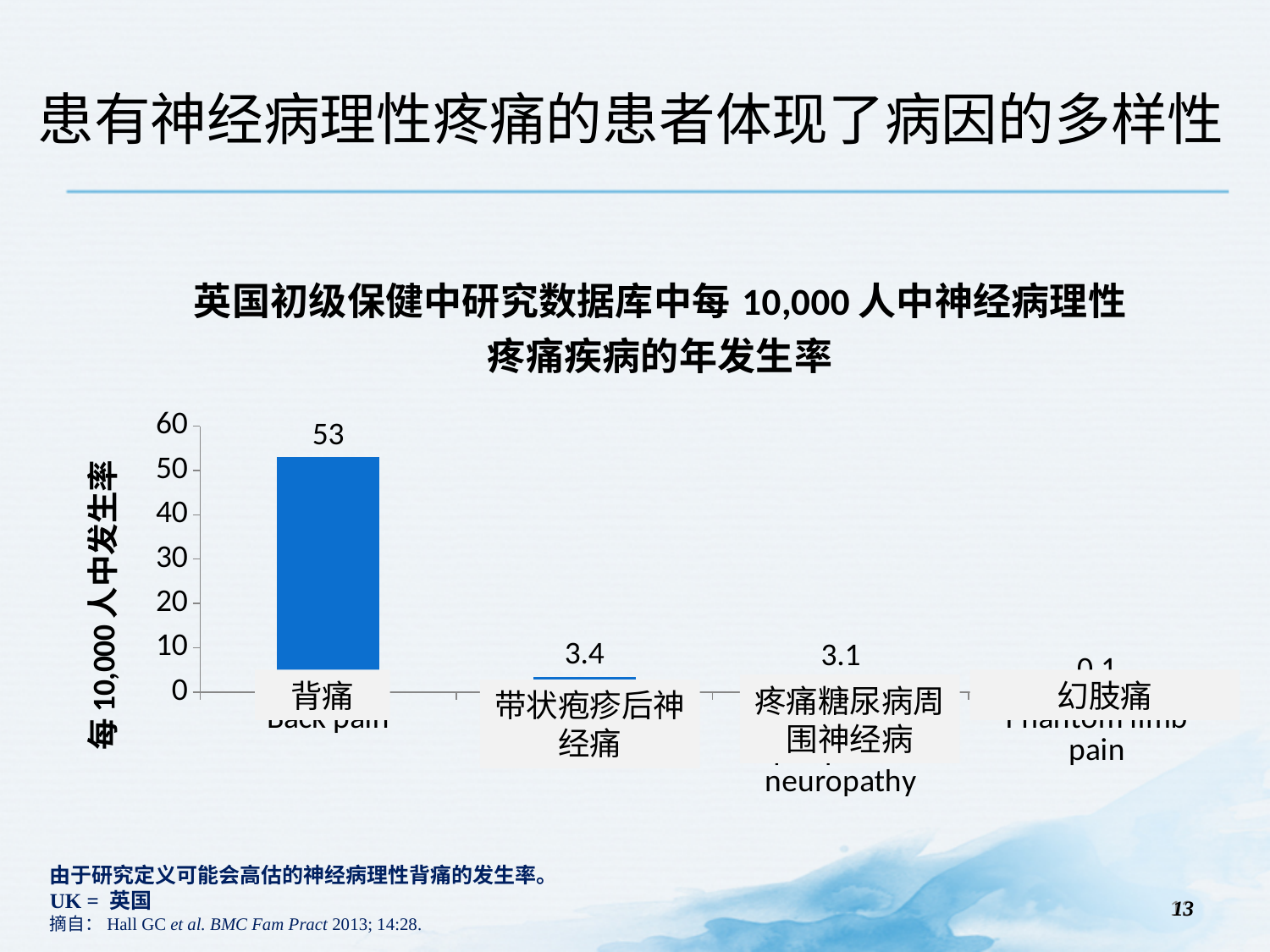
What kind of chart is shown on the slide? bar chart Which category has the highest value? 背痛 (Back pain) What is the highest tick value shown on the y axis? 60 What is the value for 带状疱疹后神经痛? 3.4 Which category has the lowest value? 幻肢痛 (Phantom limb pain) What is the difference between the values for 背痛 and 带状疱疹后神经痛? 49.6 What is the value for 背痛 (Back pain)? 53 What is the difference between the values for 带状疱疹后神经痛 and 疼痛糖尿病周围神经病? 0.3 Is the value for 幻肢痛 greater or less than 10? less Which is larger, the value for 带状疱疹后神经痛 or the value for 疼痛糖尿病周围神经病? 带状疱疹后神经痛 What is the value for 疼痛糖尿病周围神经病? 3.1 How many categories are shown in the chart? 4